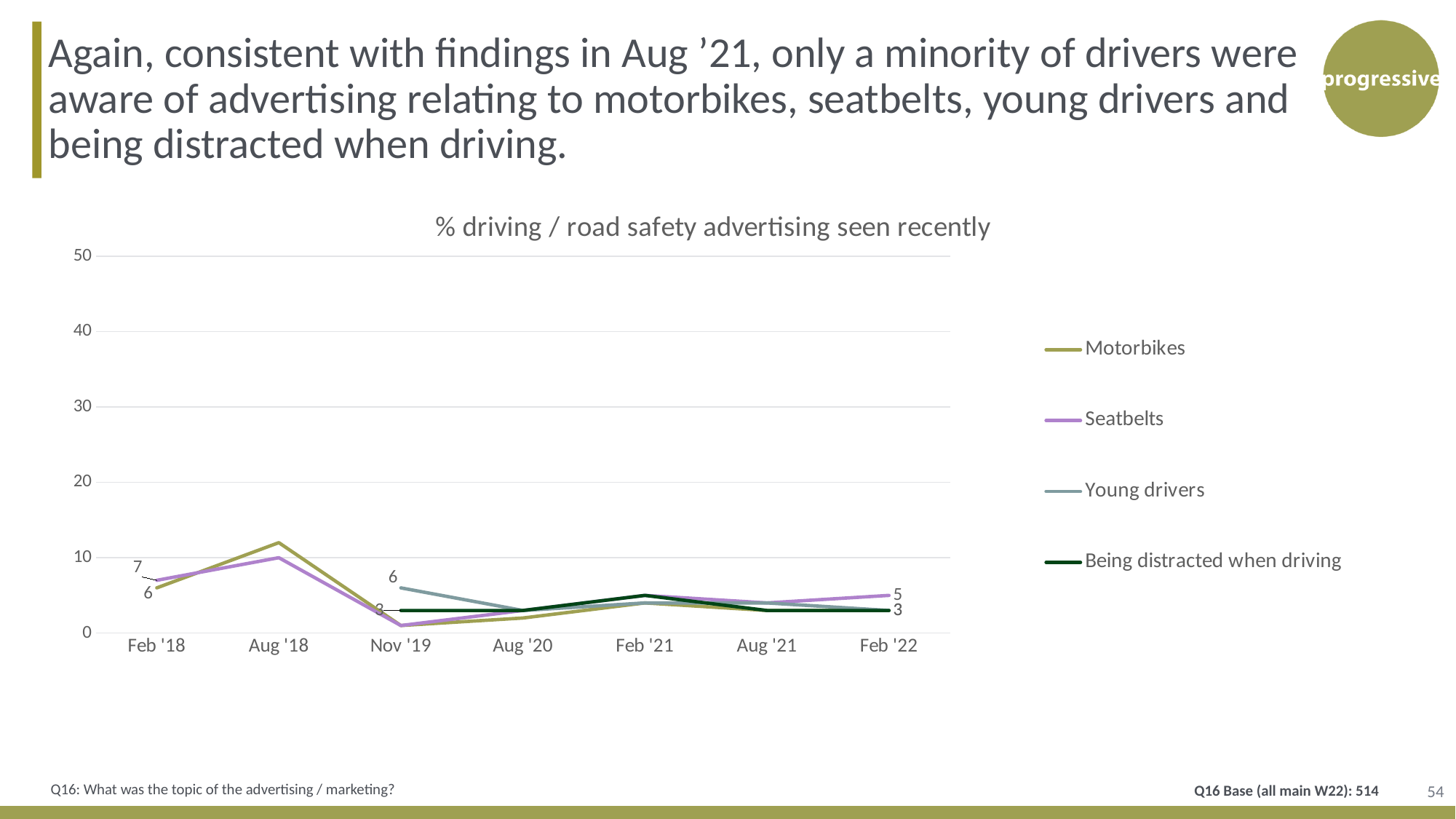
What kind of chart is shown on the slide? line chart How many series does the legend list? 4 What is the value for Seatbelts at Feb '22? 5 What is the value for Young drivers at Nov '19? 6 What is the value for Motorbikes at Feb '18? 6 By how much did the Seatbelts value fall from Feb '18 to Feb '22? 2 How many time points are shown on the x axis? 7 What is the title of the chart? % driving / road safety advertising seen recently Is the value for Motorbikes at Aug '18 greater or less than 10? greater What is the value for Seatbelts at Feb '18? 7 At Feb '18, which is higher: Seatbelts or Motorbikes? Seatbelts What is the value for Being distracted when driving at Nov '19? 3